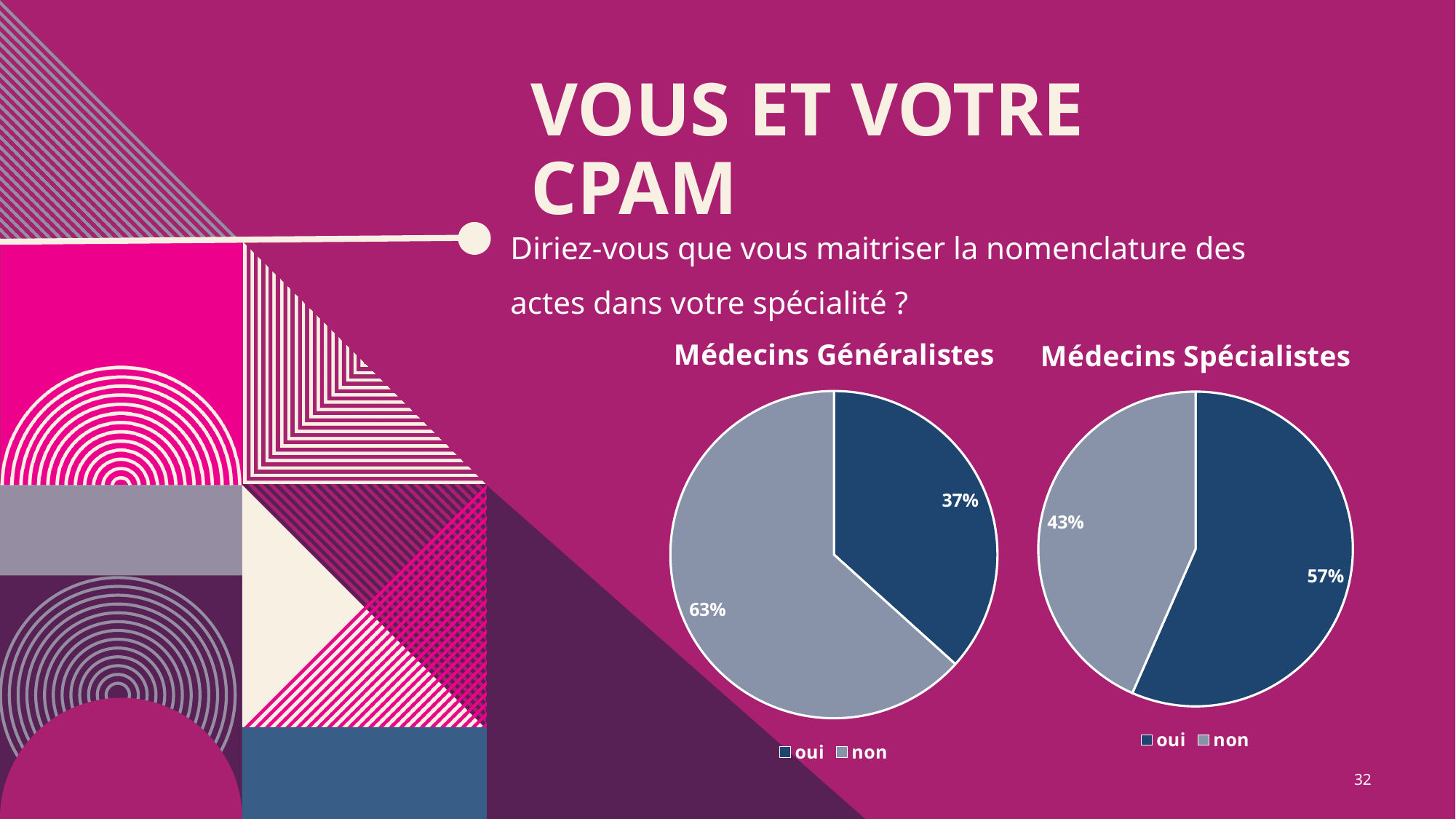
In the 'Médecins Spécialistes' pie chart, what is the difference between the 'oui' and 'non' shares? 14% In the 'Médecins Généralistes' pie chart, what is the difference between the 'non' and 'oui' shares? 26% In the 'Médecins Spécialistes' pie chart, what is the share for 'non'? 43% In the 'Médecins Généralistes' pie chart, what is the share for 'oui'? 37% In the 'Médecins Généralistes' pie chart, what is the share for 'non'? 63% What type of chart is used for 'Médecins Généralistes'? Pie chart Is the 'oui' share larger in the 'Médecins Généralistes' chart or the 'Médecins Spécialistes' chart? Médecins Spécialistes How many slices does the 'Médecins Spécialistes' pie chart have? 2 In the 'Médecins Spécialistes' pie chart, which slice is the smallest? non In the 'Médecins Généralistes' pie chart, which slice is the largest? non What entries does the legend of the 'Médecins Généralistes' chart list? oui, non In the 'Médecins Spécialistes' pie chart, what is the share for 'oui'? 57%